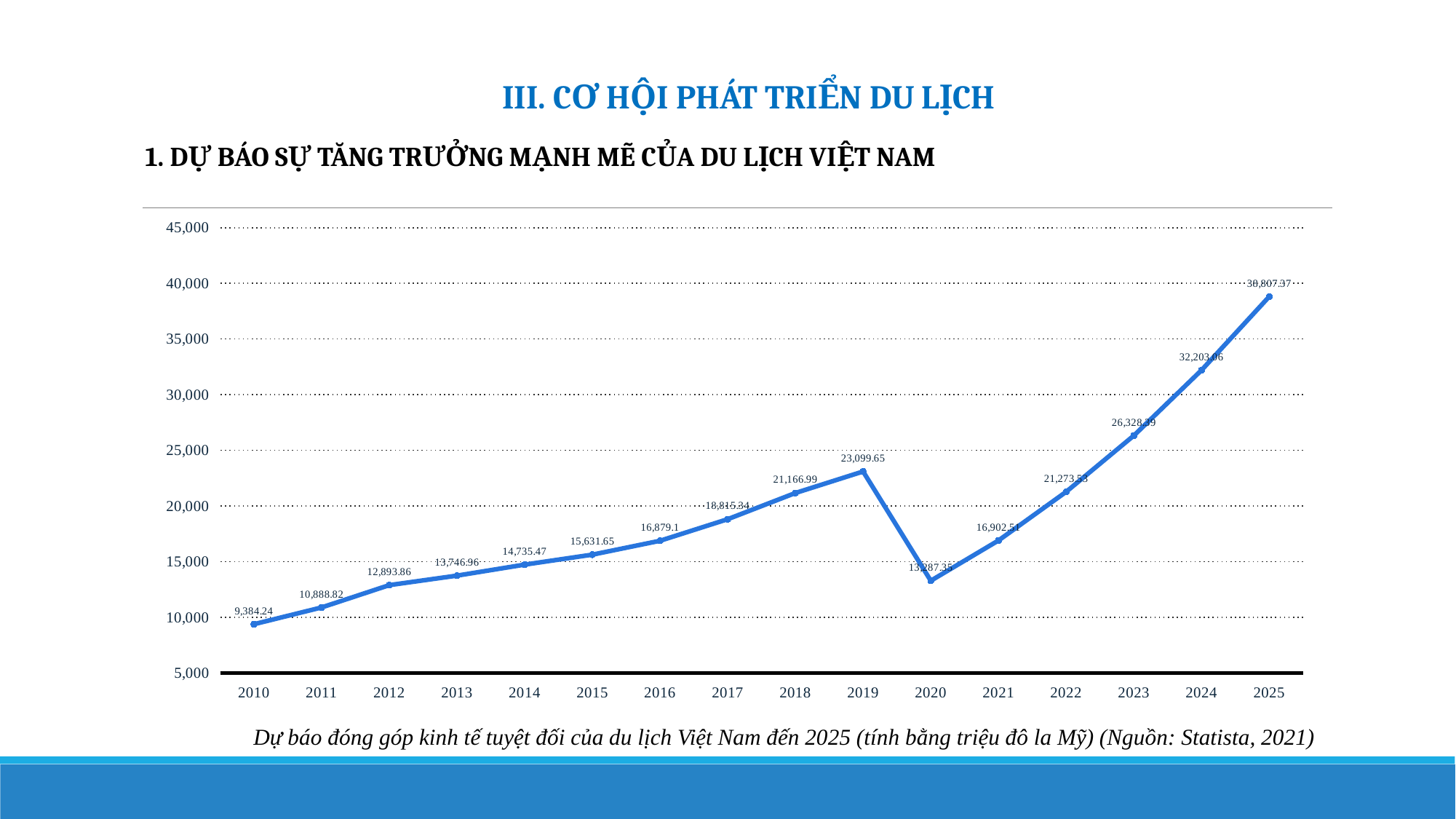
What is the value for 2010? 9,384.24 What is the value for 2021? 16,902.51 Is the value for 2025 greater or less than 35,000? greater What kind of chart is shown on the slide? line chart Which year has the lowest value? 2010 What is the difference between the values for 2019 and 2018? 1,932.66 What is the value for 2016? 16,879.1 What is the value for 2019? 23,099.65 Which is larger, the value for 2019 or the value for 2021? 2019 How many years are plotted on the x axis? 16 Is the value for 2020 greater or less than 15,000? less Which year has the highest value? 2025